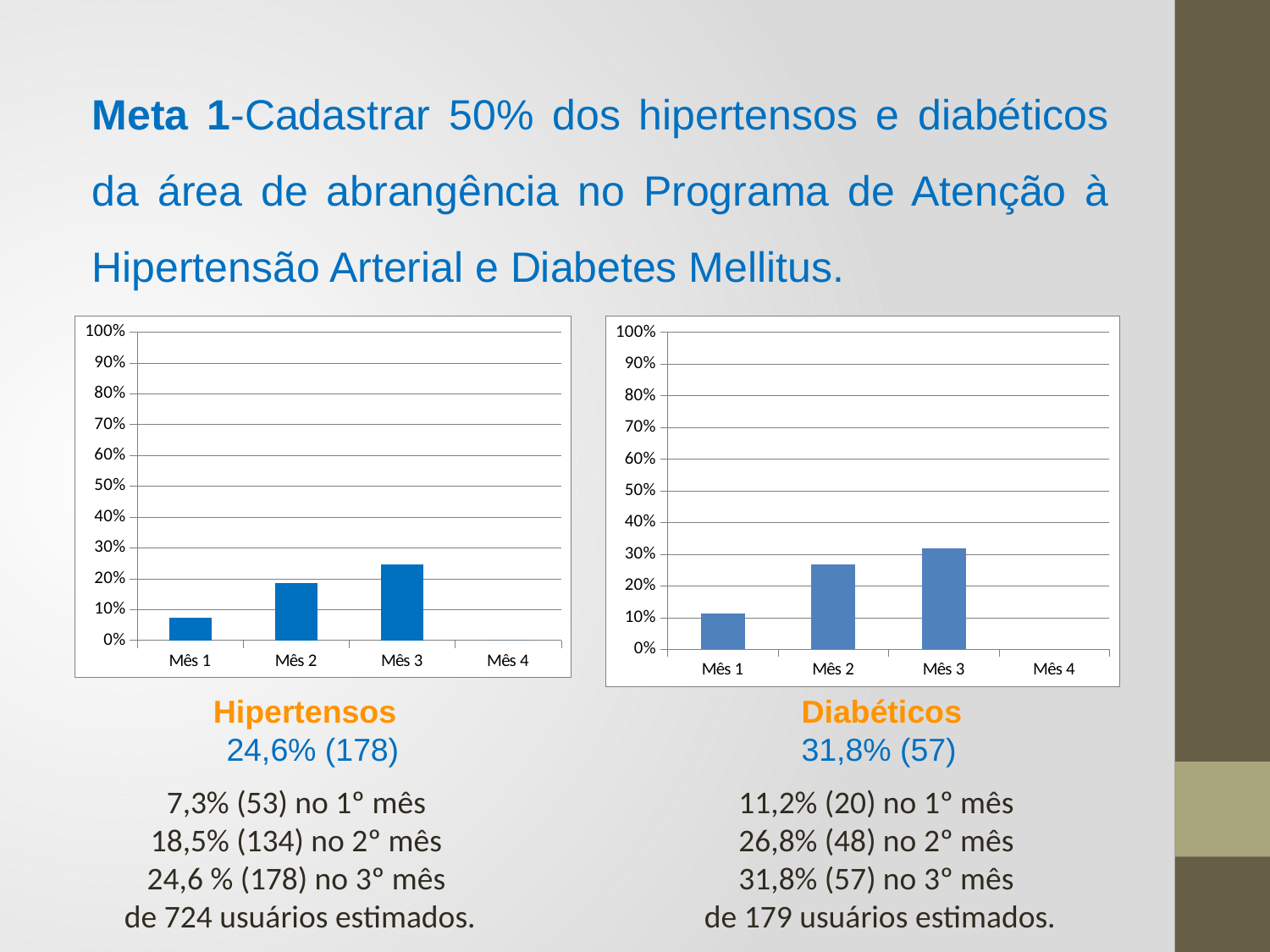
In the Hipertensos chart on the left, is the bar for Mês 2 taller or shorter than the bar for Mês 1? taller How many month categories are shown on the x axis of the Hipertensos chart on the left? 4 In the Diabéticos chart on the right, is the value for Mês 1 greater or less than 20%? less In the Hipertensos chart on the left, is the value for Mês 3 greater or less than 30%? less In the Diabéticos chart on the right, which month has the lowest non-empty bar? Mês 1 According to the slide, what percentage of hipertensos was registered in the 3rd month (Mês 3)? 24,6% Do the bars in the Diabéticos chart on the right rise or fall from Mês 1 to Mês 3? rise In the Hipertensos chart on the left, which month has the highest bar? Mês 3 According to the slide, what percentage of diabéticos was registered in the 2nd month (Mês 2)? 26,8% What kind of chart is the Hipertensos chart on the left? bar chart In the Diabéticos chart on the right, is the value for Mês 3 greater or less than 30%? greater What is the highest value shown on the y axis of the Diabéticos chart on the right? 100%